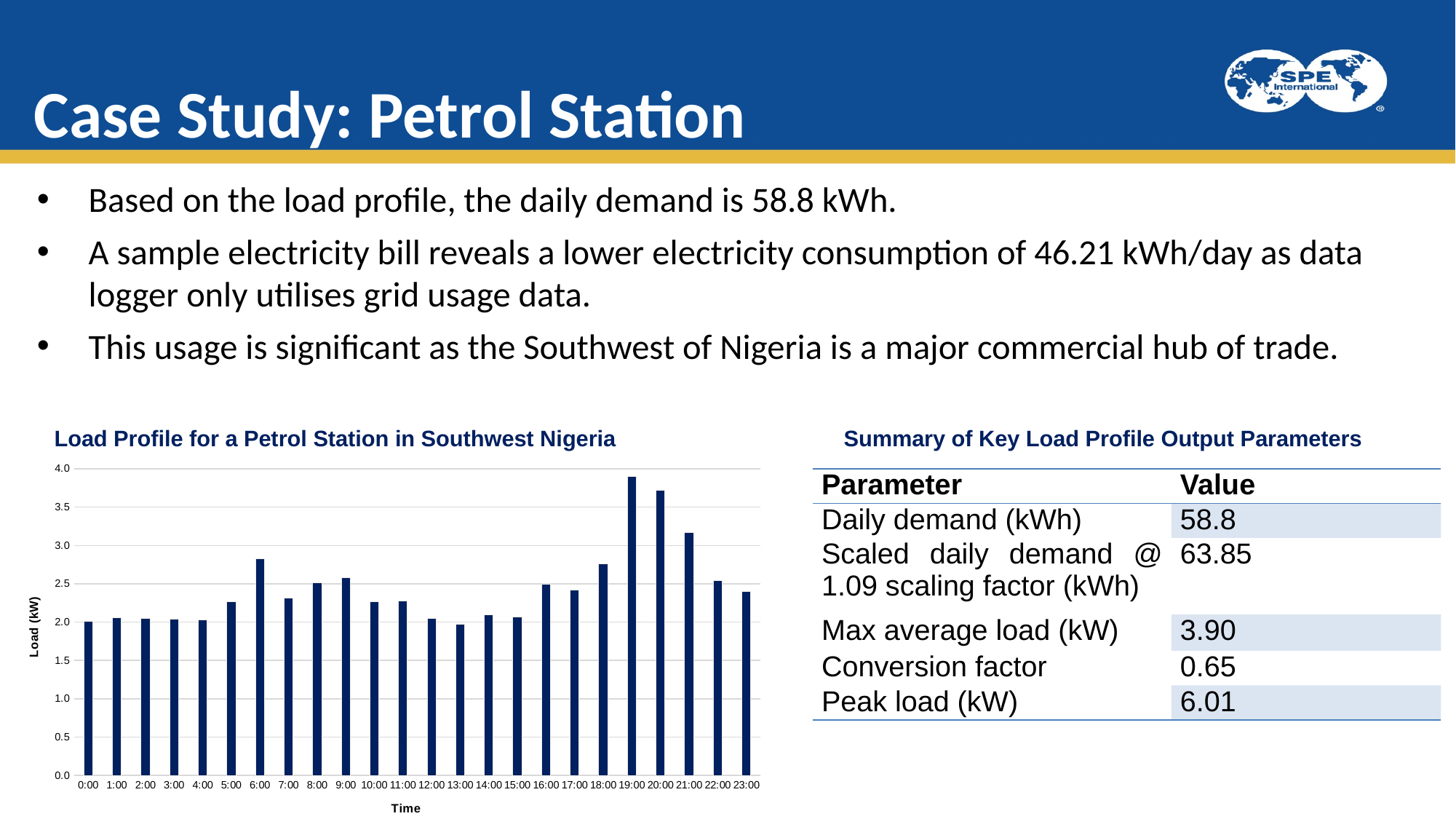
In the load profile chart, is the value for 18:00 greater or less than 2.5? greater In the load profile chart, is the value for 20:00 greater or less than 3.5? greater In the load profile chart, is the value for 3:00 greater or less than 2.5? less In the load profile chart, at which time is the load highest? 19:00 How many time categories are plotted on the x axis of the load profile chart? 24 In the load profile chart, do the values rise or fall from 19:00 to 23:00? Fall In the load profile chart, which has the larger load, 6:00 or 7:00? 6:00 What kind of chart is the Load Profile for a Petrol Station in Southwest Nigeria? Bar chart What is the label on the vertical axis of the load profile chart? Load (kW) In the load profile chart, which has the larger load, 21:00 or 22:00? 21:00